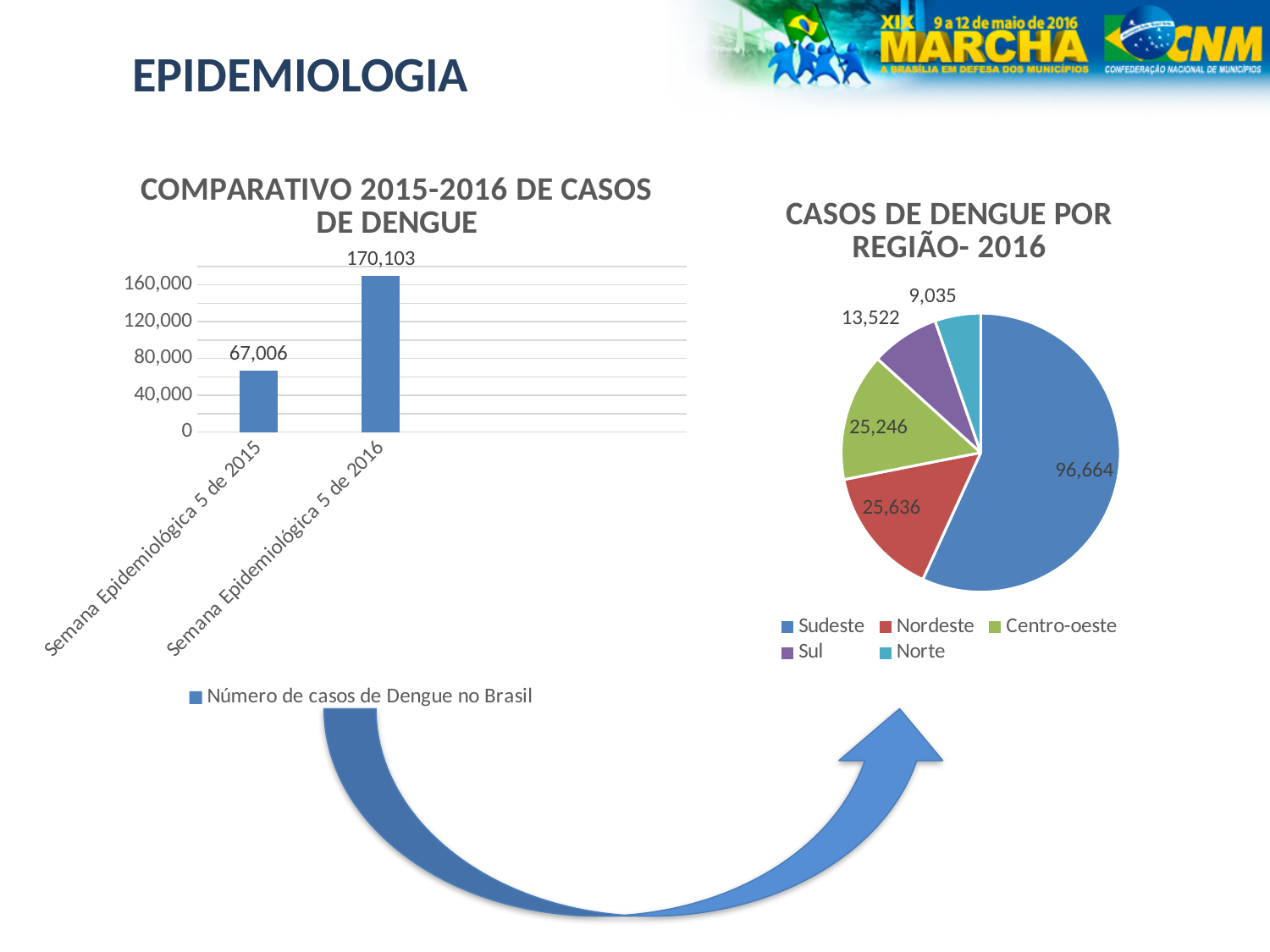
In the bar chart 'COMPARATIVO 2015-2016 DE CASOS DE DENGUE', what series name does the legend show? Número de casos de Dengue no Brasil In the pie chart 'CASOS DE DENGUE POR REGIÃO- 2016', what is the difference between Sul and Norte? 4,487 In the bar chart 'COMPARATIVO 2015-2016 DE CASOS DE DENGUE', what is the difference between the 2016 and 2015 values? 103,097 How many regions does the legend of the pie chart 'CASOS DE DENGUE POR REGIÃO- 2016' list? 5 What type of chart is 'COMPARATIVO 2015-2016 DE CASOS DE DENGUE'? Bar chart In the pie chart 'CASOS DE DENGUE POR REGIÃO- 2016', what is the value for Sul? 13,522 In the bar chart 'COMPARATIVO 2015-2016 DE CASOS DE DENGUE', how many bars are plotted? 2 In the pie chart 'CASOS DE DENGUE POR REGIÃO- 2016', which is larger, Nordeste or Centro-oeste? Nordeste In the bar chart 'COMPARATIVO 2015-2016 DE CASOS DE DENGUE', what is the value for Semana Epidemiológica 5 de 2016? 170,103 In the pie chart 'CASOS DE DENGUE POR REGIÃO- 2016', what is the value for Sudeste? 96,664 In the pie chart 'CASOS DE DENGUE POR REGIÃO- 2016', which region has the lowest number of cases? Norte In the bar chart 'COMPARATIVO 2015-2016 DE CASOS DE DENGUE', what is the value for Semana Epidemiológica 5 de 2015? 67,006